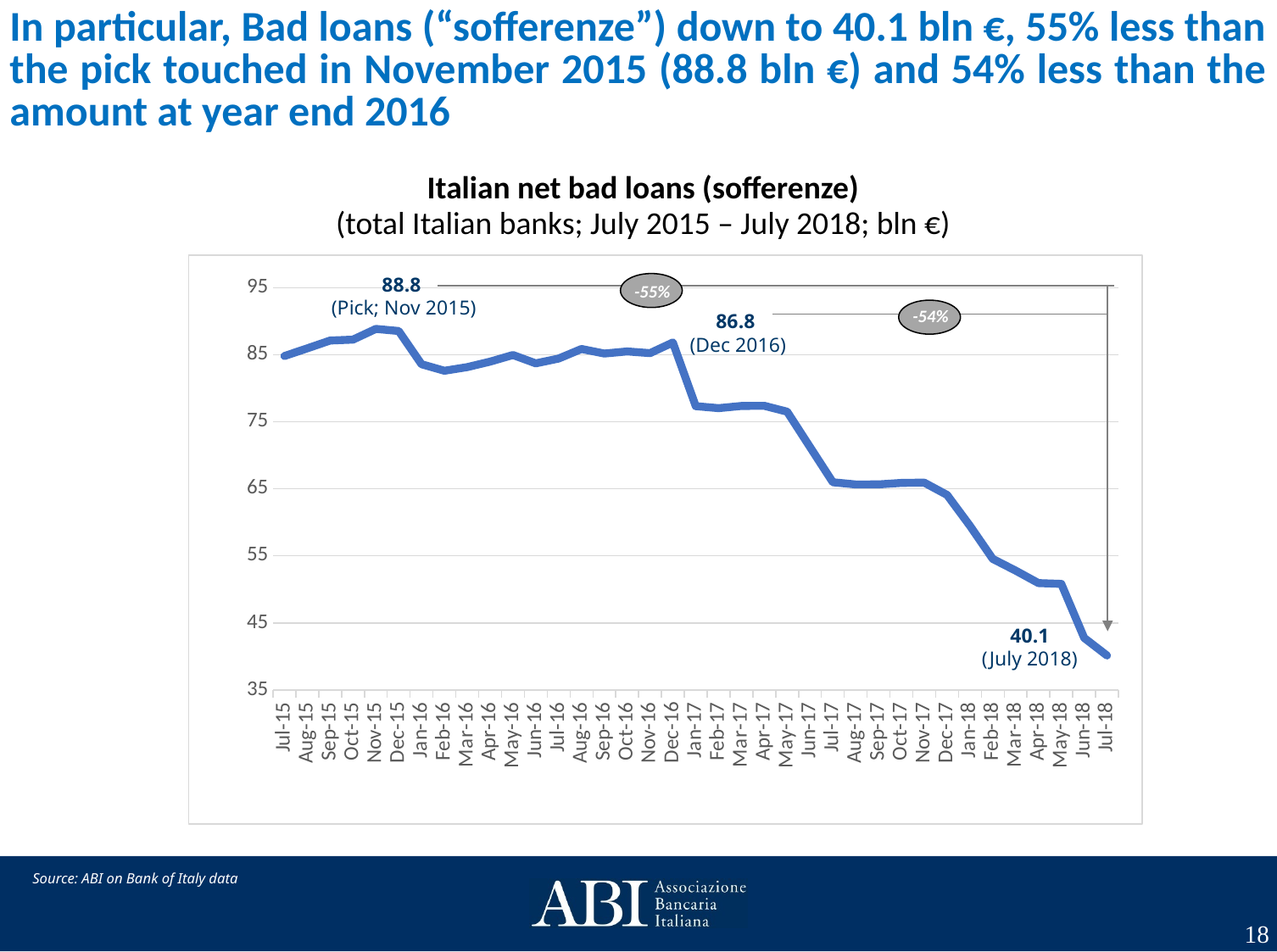
What is the difference between the December 2016 value and the July 2018 value? 46.7 What kind of chart is shown on the slide? line chart Is the value for Jul-17 greater or less than 75? less Which is larger, the value in November 2015 or the value in December 2016? November 2015 In which month does the line reach its highest value? Nov-15 What is the value of Italian net bad loans in November 2015, the peak? 88.8 In which month does the line reach its lowest value? Jul-18 Is the value for Jan-17 greater or less than 85? less What is the value of Italian net bad loans in December 2016? 86.8 What is the difference between the peak value in November 2015 and the value in July 2018? 48.7 What percentage decline from the November 2015 peak to July 2018 is annotated on the chart? -55% What is the value of Italian net bad loans in July 2018? 40.1